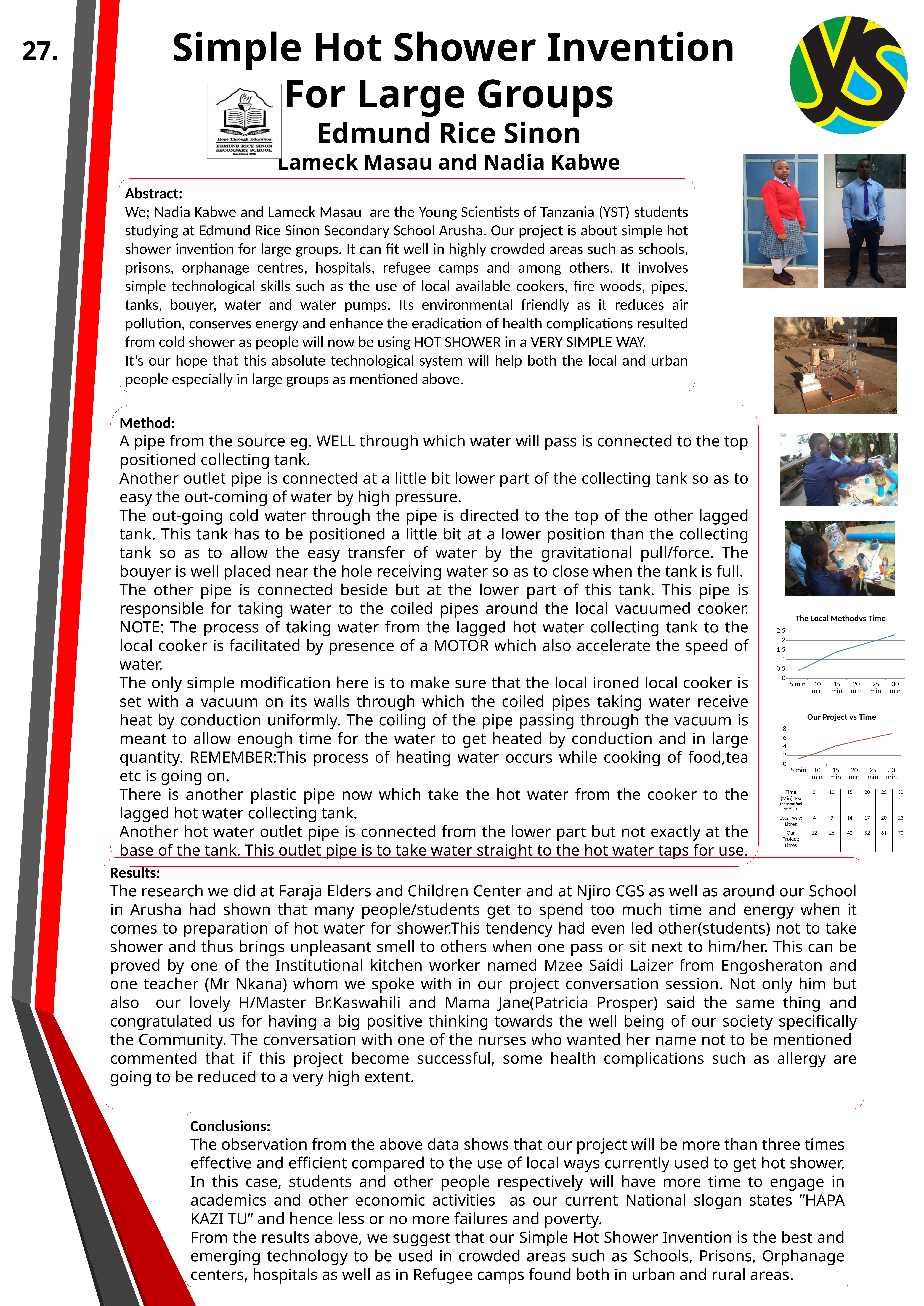
How many time points are plotted on the x axis of "The Local Methodvs Time"? 6 In "Our Project vs Time", do the values rise or fall as time increases from 5 min to 30 min? rise In "The Local Methodvs Time", do the values rise or fall as time increases from 5 min to 30 min? rise In "The Local Methodvs Time", is the value at 30 min greater or less than 2? greater In "Our Project vs Time", is the value at 5 min greater or less than 2? less In "The Local Methodvs Time", is the value at 5 min greater or less than 1? less What kind of chart is "Our Project vs Time"? line chart What is the highest value shown on the y axis of "The Local Methodvs Time"? 2.5 What is the highest value shown on the y axis of "Our Project vs Time"? 8 How many time points are plotted on the x axis of "Our Project vs Time"? 6 What kind of chart is "The Local Methodvs Time"? line chart